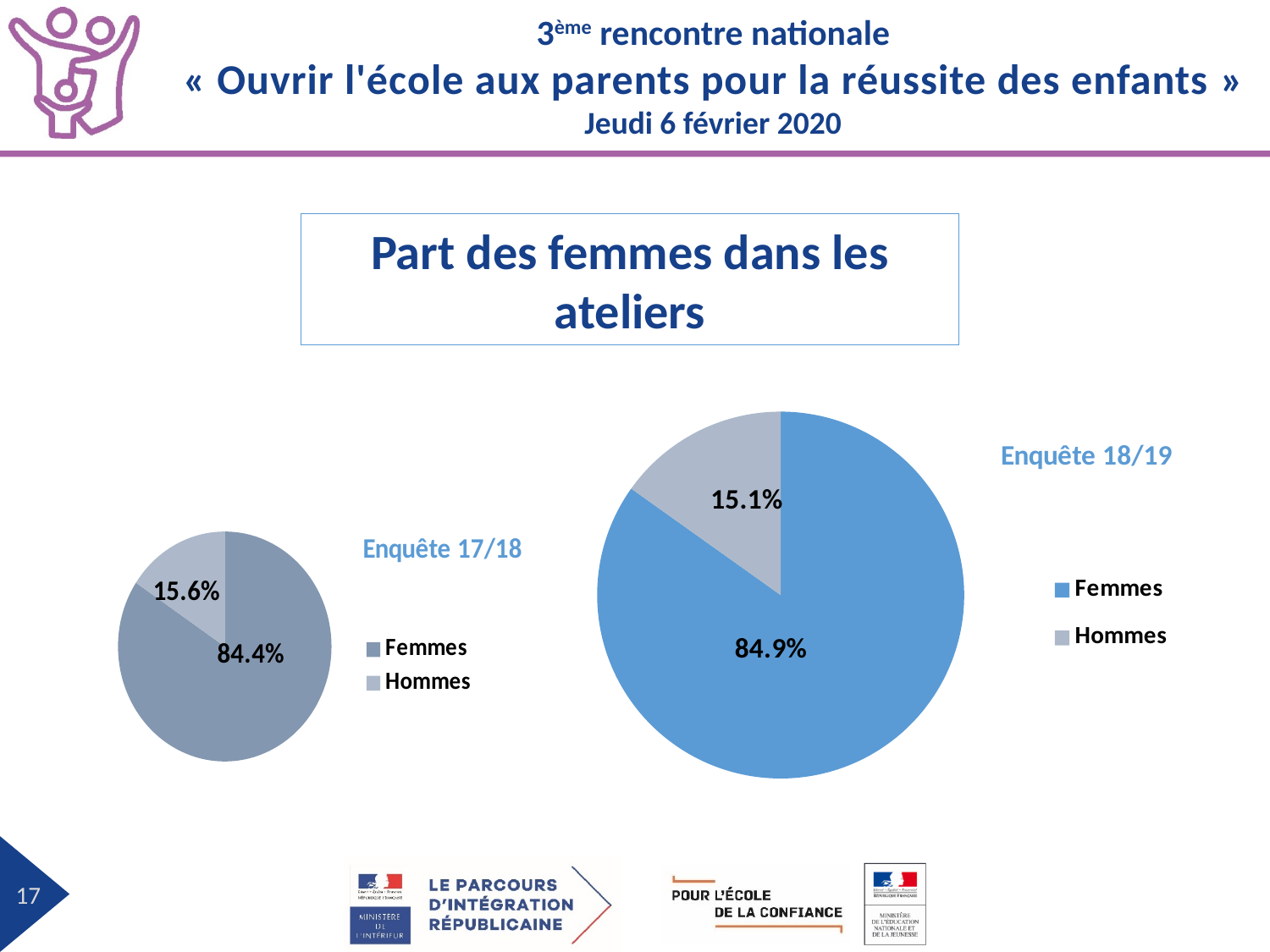
How many categories does the Enquête 17/18 pie chart show? 2 How many charts are on the slide? 2 In the Enquête 18/19 pie chart, which category has the largest slice? Femmes In the Enquête 18/19 pie chart, what is the share for Hommes? 15.1% What is the title shown above the charts? Part des femmes dans les ateliers In the Enquête 17/18 pie chart, which category has the smallest slice? Hommes Is the Femmes share larger in the Enquête 17/18 chart or the Enquête 18/19 chart? Enquête 18/19 In the Enquête 17/18 pie chart, what is the difference between the Femmes and Hommes shares? 68.8% In the Enquête 17/18 pie chart, what is the share for Hommes? 15.6% What kind of chart is used for Enquête 18/19? Pie chart In the Enquête 18/19 pie chart, what is the share for Femmes? 84.9% In the Enquête 17/18 pie chart, what is the share for Femmes? 84.4%